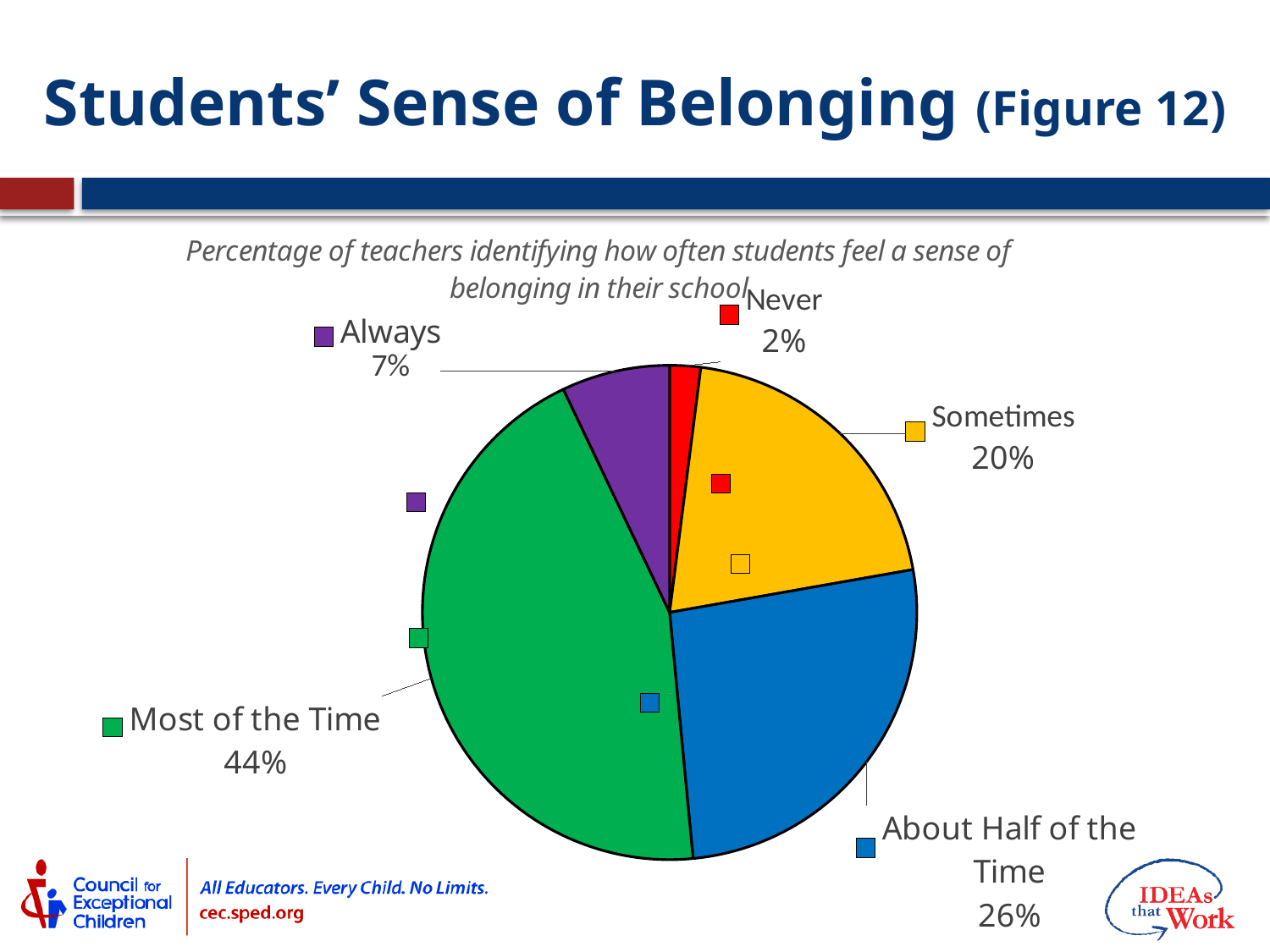
What type of chart is shown on the slide? Pie chart Which category has the largest share of the pie? Most of the Time Which is larger, the Sometimes slice or the Always slice? Sometimes What colour is the Most of the Time slice? Green What percentage of teachers said students feel a sense of belonging Most of the Time? 44% What percentage is shown for About Half of the Time? 26% What percentage is shown for the Never slice? 2% What percentage is shown for the Sometimes slice? 20% What is the difference in percentage points between Most of the Time and About Half of the Time? 18 What percentage is shown for the Always slice? 7% How many categories are shown in the pie chart? 5 Which category has the smallest share of the pie? Never